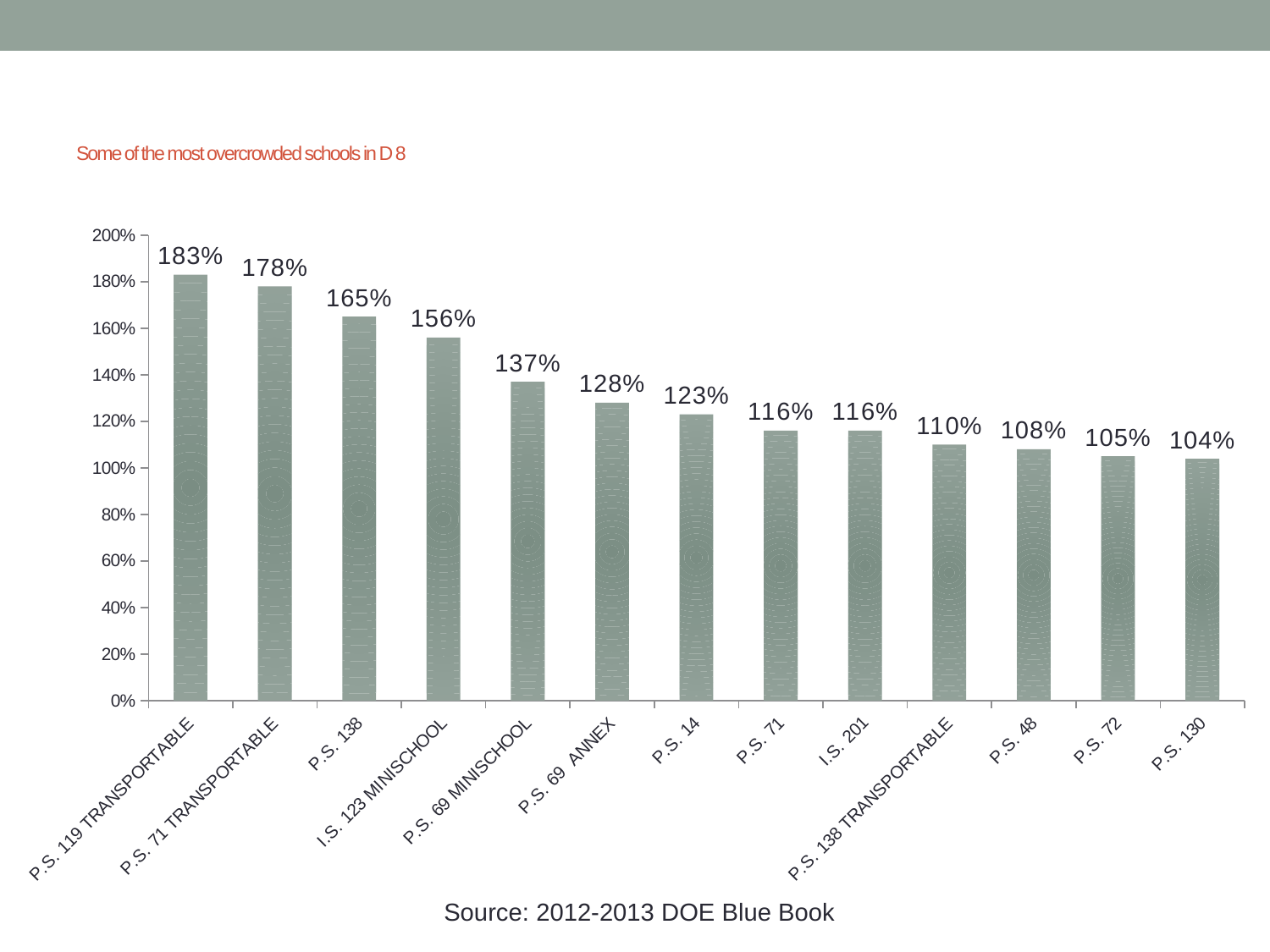
Which school has the highest value? P.S. 119 TRANSPORTABLE Which school has the lowest value? P.S. 130 Do the values rise or fall from left to right along the x axis? fall What kind of chart is shown on the slide? bar chart How many schools are shown in the chart? 13 What is the title of the chart? Some of the most overcrowded schools in D 8 Which is larger, the value for P.S. 69 MINISCHOOL or the value for P.S. 69 ANNEX? P.S. 69 MINISCHOOL What is the value for P.S. 119 TRANSPORTABLE? 183% What is the value for I.S. 123 MINISCHOOL? 156% What is the value for P.S. 48? 108% What is the difference between the values for P.S. 14 and P.S. 130? 19% What is the difference between the values for P.S. 71 TRANSPORTABLE and P.S. 138? 13%